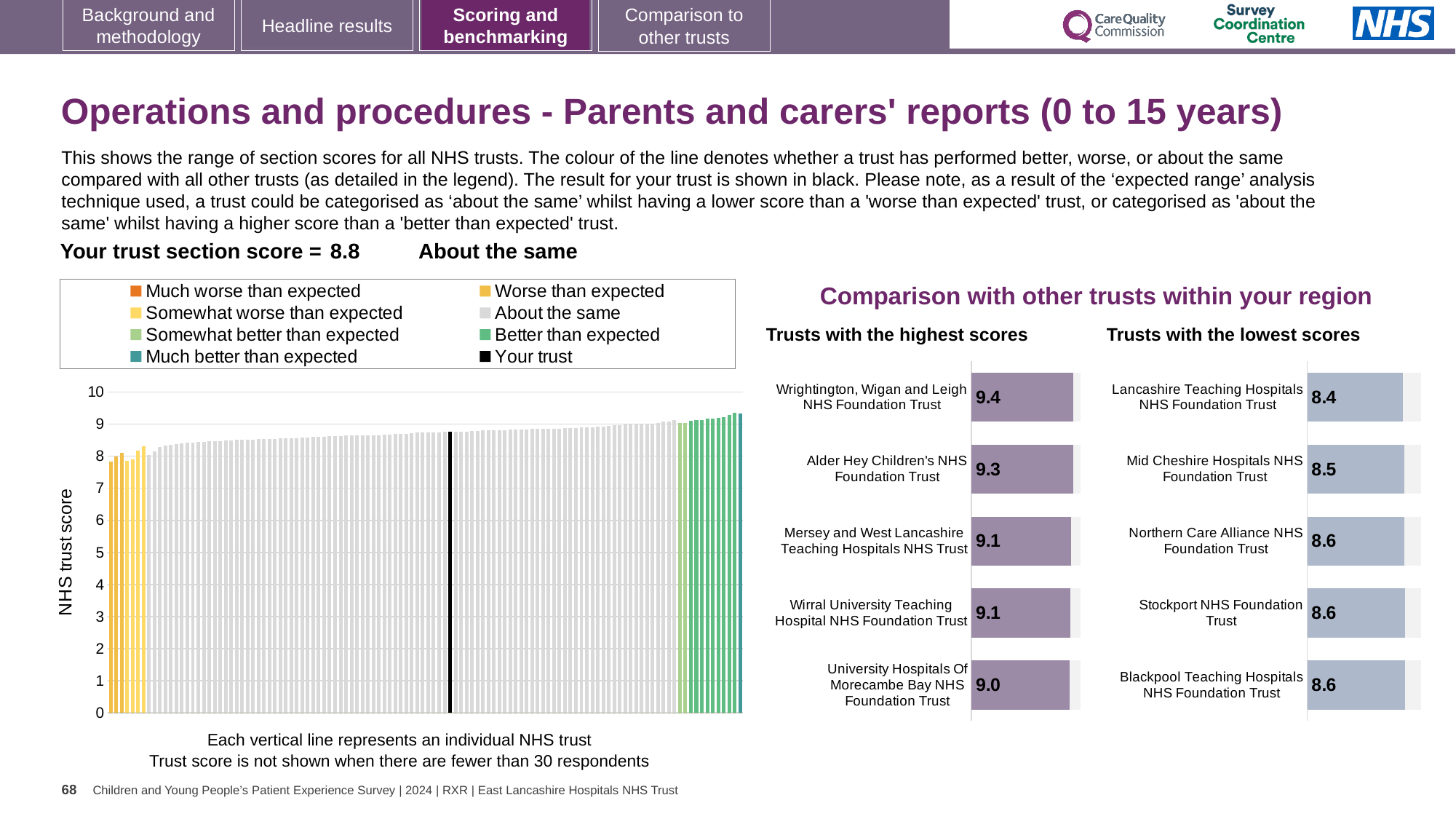
What kind of chart is the large chart on the left showing all NHS trust scores? Bar chart In the 'Trusts with the highest scores' chart, what is the difference between the scores of Wrightington, Wigan and Leigh NHS Foundation Trust and University Hospitals Of Morecambe Bay NHS Foundation Trust? 0.4 In the 'Trusts with the lowest scores' chart, what is the score for Lancashire Teaching Hospitals NHS Foundation Trust? 8.4 In the 'Trusts with the highest scores' chart, what is the score for University Hospitals Of Morecambe Bay NHS Foundation Trust? 9.0 In the 'Trusts with the lowest scores' chart, what is the difference between the scores of Blackpool Teaching Hospitals NHS Foundation Trust and Lancashire Teaching Hospitals NHS Foundation Trust? 0.2 In the 'Trusts with the highest scores' chart, what is the score for Wrightington, Wigan and Leigh NHS Foundation Trust? 9.4 How many entries does the legend above the large chart on the left list? 8 In the 'Trusts with the highest scores' chart, how many trusts are shown? 5 In the 'Trusts with the lowest scores' chart, which has the larger score: Mid Cheshire Hospitals NHS Foundation Trust or Lancashire Teaching Hospitals NHS Foundation Trust? Mid Cheshire Hospitals NHS Foundation Trust In the 'Trusts with the highest scores' chart, which trust has the highest score? Wrightington, Wigan and Leigh NHS Foundation Trust In the 'Trusts with the lowest scores' chart, which trust has the lowest score? Lancashire Teaching Hospitals NHS Foundation Trust In the large chart on the left, do the trust scores rise or fall from left to right along the x axis? Rise